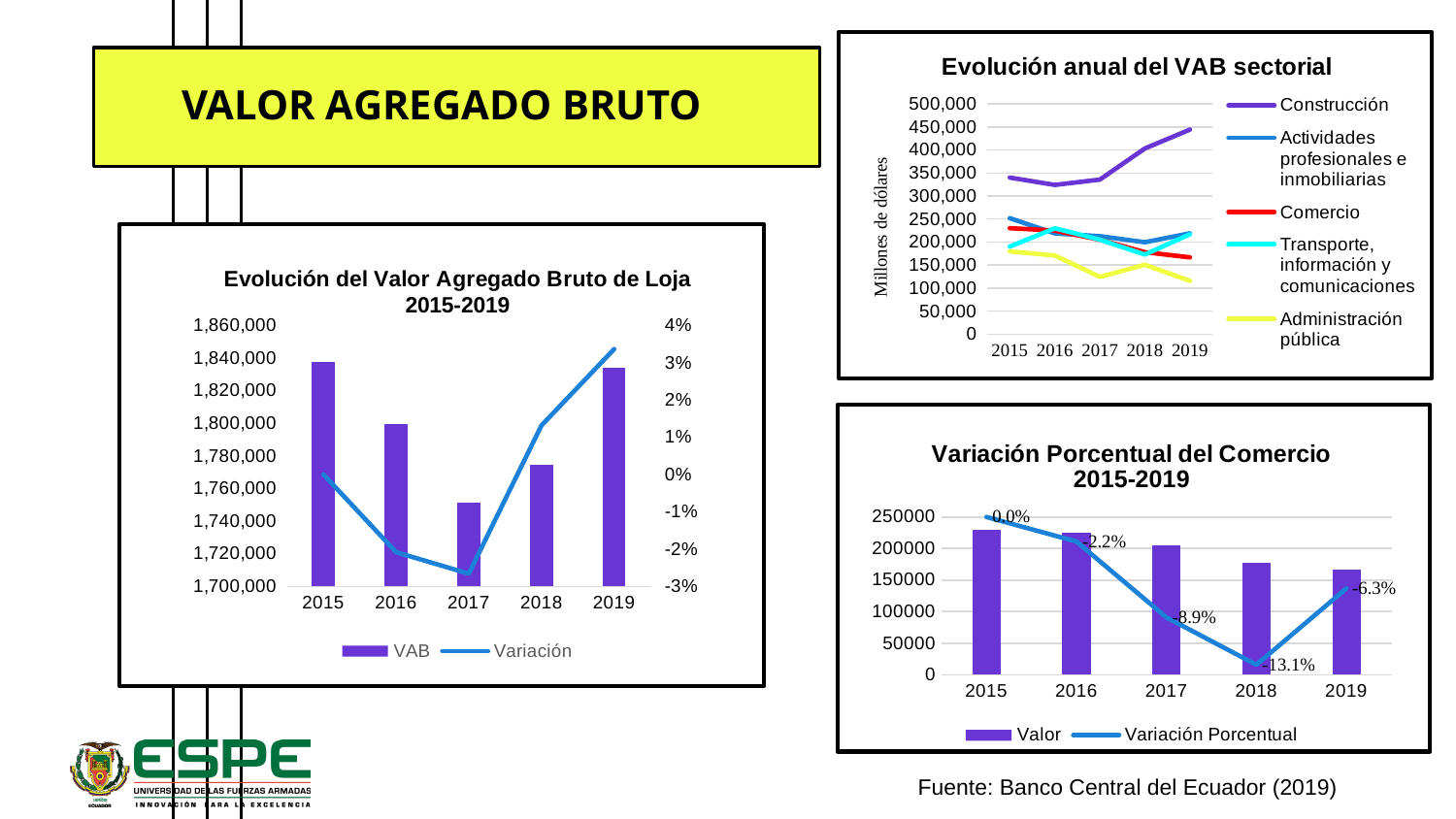
In the chart titled 'Evolución del Valor Agregado Bruto de Loja 2015-2019', how many years are shown on the x axis? 5 In the chart titled 'Evolución anual del VAB sectorial', what is the label on the vertical axis? Millones de dólares In the chart titled 'Evolución anual del VAB sectorial', which sector has the lowest value in 2019? Administración pública In the chart titled 'Variación Porcentual del Comercio 2015-2019', which year has the lowest Variación Porcentual? 2018 In the chart titled 'Evolución del Valor Agregado Bruto de Loja 2015-2019', is the VAB value for 2017 greater or less than 1,760,000? less In the chart titled 'Variación Porcentual del Comercio 2015-2019', what is the Variación Porcentual value for 2018? -13.1% In the chart titled 'Variación Porcentual del Comercio 2015-2019', what is the difference between the Variación Porcentual values for 2016 and 2017? 6.7 percentage points In the chart titled 'Evolución del Valor Agregado Bruto de Loja 2015-2019', which year has the lowest VAB bar? 2017 In the chart titled 'Evolución del Valor Agregado Bruto de Loja 2015-2019', how many series does the legend list? 2 In the chart titled 'Variación Porcentual del Comercio 2015-2019', do the Valor bars rise or fall from 2015 to 2019? fall In the chart titled 'Evolución anual del VAB sectorial', which sector has the highest value in 2019? Construcción In the chart titled 'Evolución anual del VAB sectorial', how many series does the legend list? 5